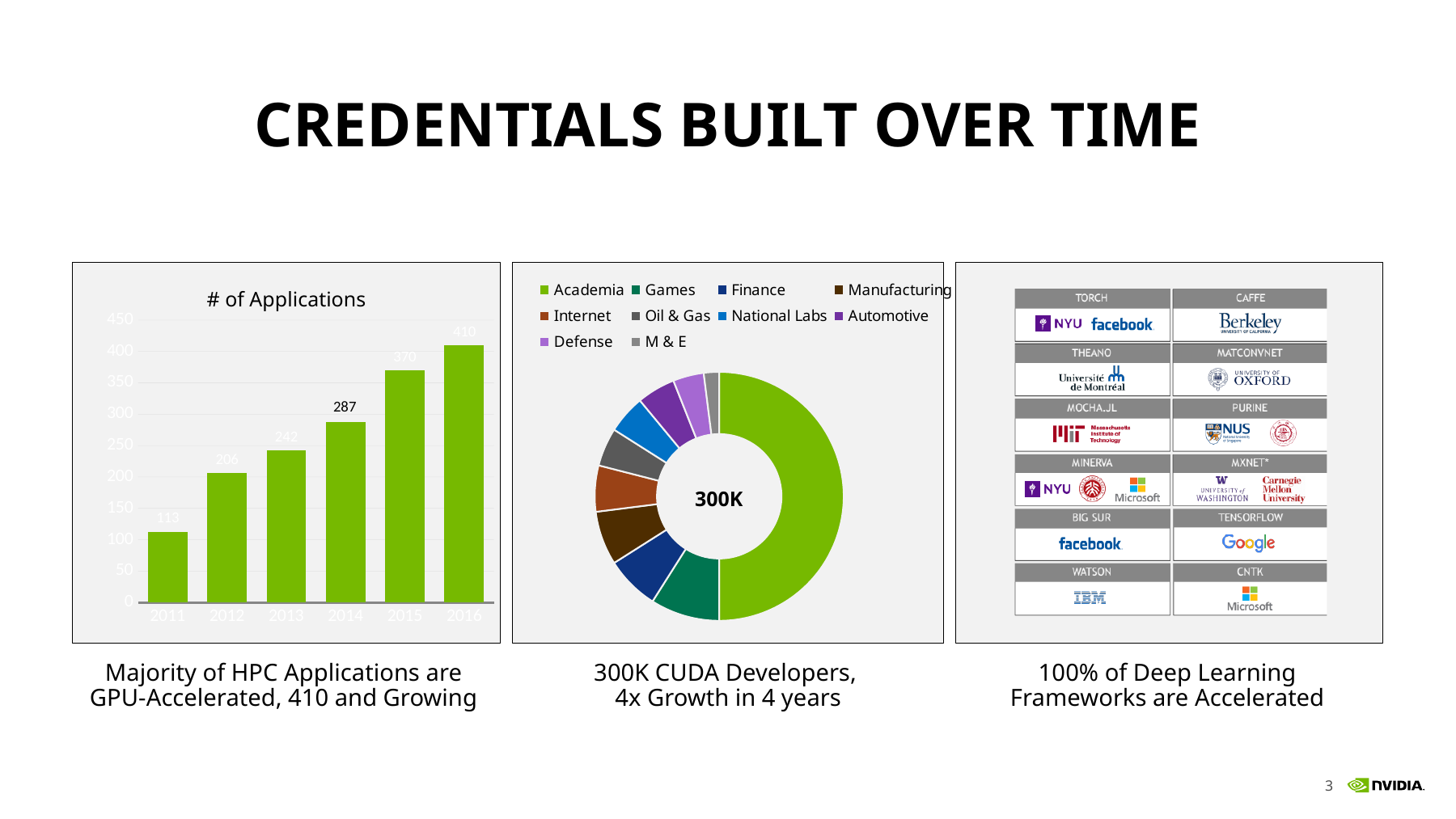
In the '# of Applications' chart, what is the value for 2016? 410 In the '# of Applications' chart, which year has the highest value? 2016 What kind of chart is the '# of Applications' chart on the left? bar chart In the '# of Applications' chart, what is the value for 2014? 287 In the '# of Applications' chart, which year has the lowest value? 2011 In the '# of Applications' chart, what is the value for 2011? 113 In the middle donut chart, which category has the largest slice? Academia In the '# of Applications' chart, is the value for 2015 greater or less than 350? greater In the '# of Applications' chart, what is the difference between the values for 2016 and 2014? 123 In the '# of Applications' chart, how many years are shown on the x axis? 6 In the '# of Applications' chart, do the values rise or fall from 2011 to 2016? rise In the middle donut chart, how many categories does the legend list? 10